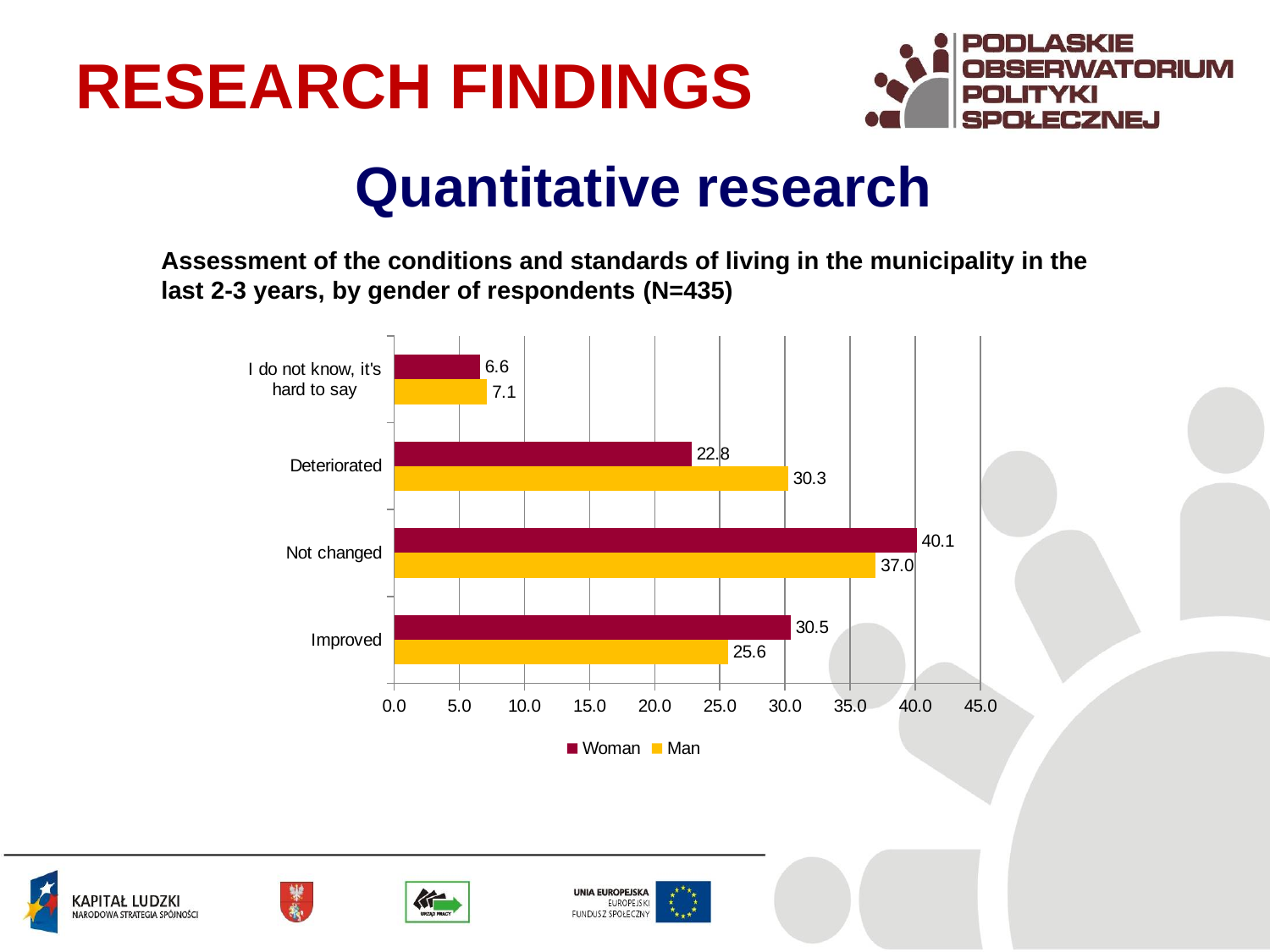
Which category has the lowest value for Man? I do not know, it's hard to say Which colour represents the Man series in the chart? yellow In the Deteriorated category, which is larger, the value for Woman or for Man? Man Is the value for Woman in the Not changed category greater or less than 35.0? greater How many series does the legend list? 2 What is the value for Man in the Deteriorated category? 30.3 What is the difference between the Woman and Man values in the Improved category? 4.9 What is the value for Man in the Improved category? 25.6 What kind of chart is shown on the slide? bar chart What is the value for Woman in the Not changed category? 40.1 Which category has the highest value for Woman? Not changed How many categories are shown on the chart? 4